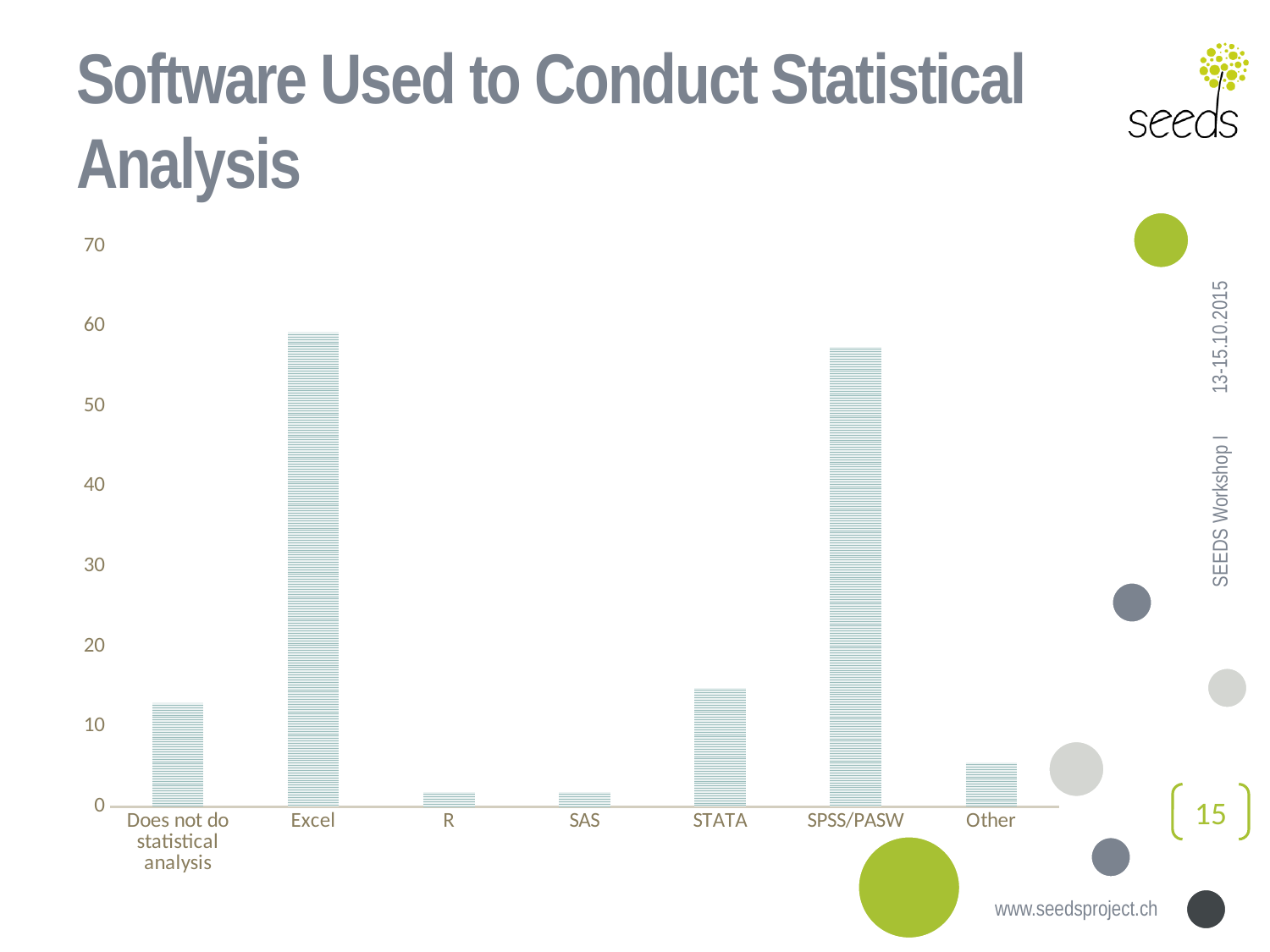
Is the value for Excel greater or less than 50? greater How many software categories are shown on the x axis of the chart? 7 Is the value for SPSS/PASW greater or less than 50? greater What kind of chart is shown on the slide? bar chart Is the value for SAS greater or less than 10? less Which has the larger value, STATA or Other? STATA Which has the larger value, Excel or STATA? Excel What is the title of the chart on the slide? Software Used to Conduct Statistical Analysis